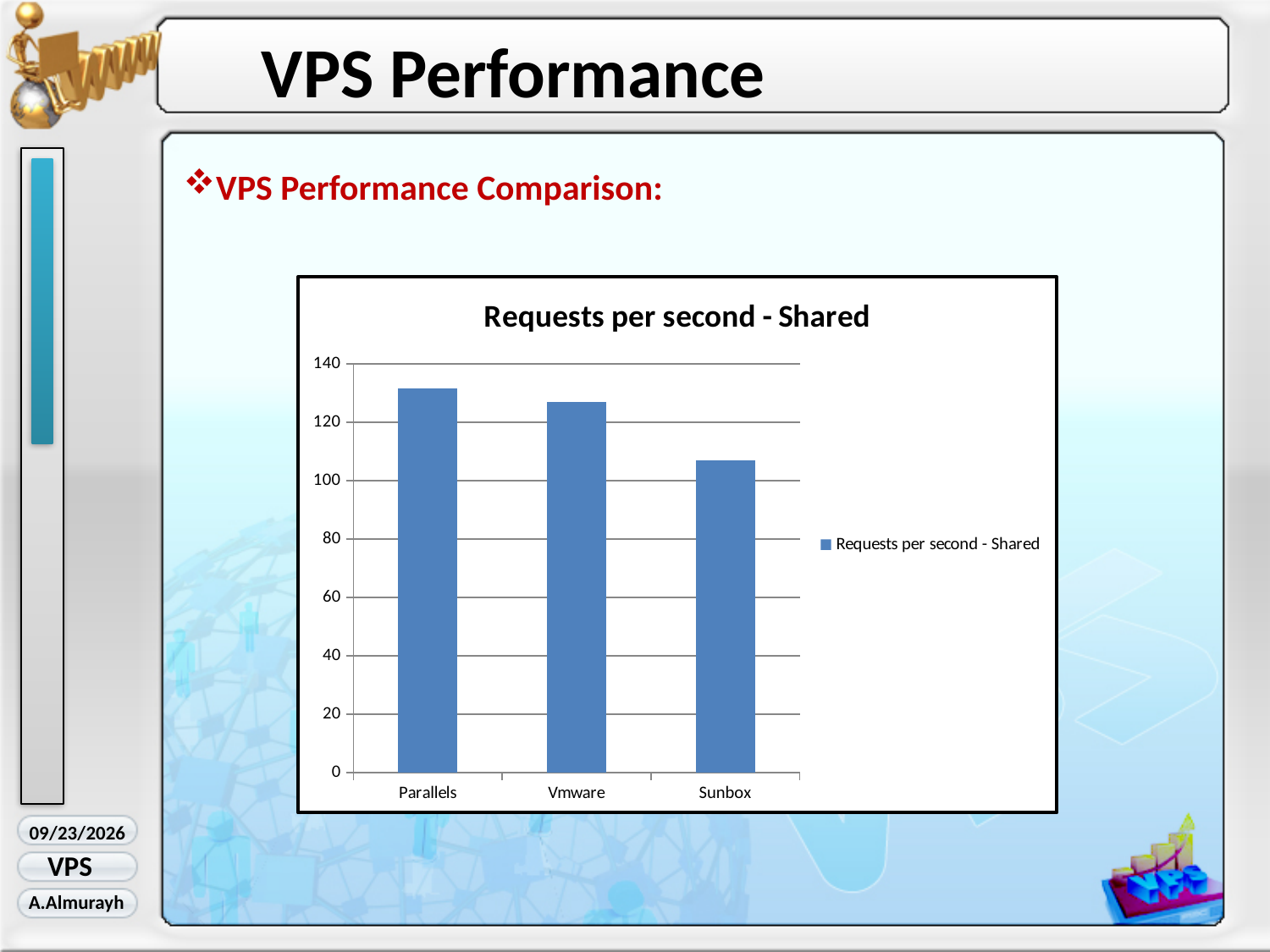
What is the name of the series shown in the legend? Requests per second - Shared Which category has the lowest requests per second? Sunbox How many categories are plotted on the x axis of the chart? 3 Is the value for Parallels greater or less than 120? greater Which category has the highest requests per second? Parallels Is the value for Sunbox greater or less than 120? less Is the value for Sunbox greater or less than 100? greater What is the title of the chart? Requests per second - Shared Do the values rise or fall from Parallels to Sunbox along the x axis? fall What kind of chart is shown on the slide? bar chart Which is larger, the value for Vmware or the value for Sunbox? Vmware How many series does the chart legend list? 1